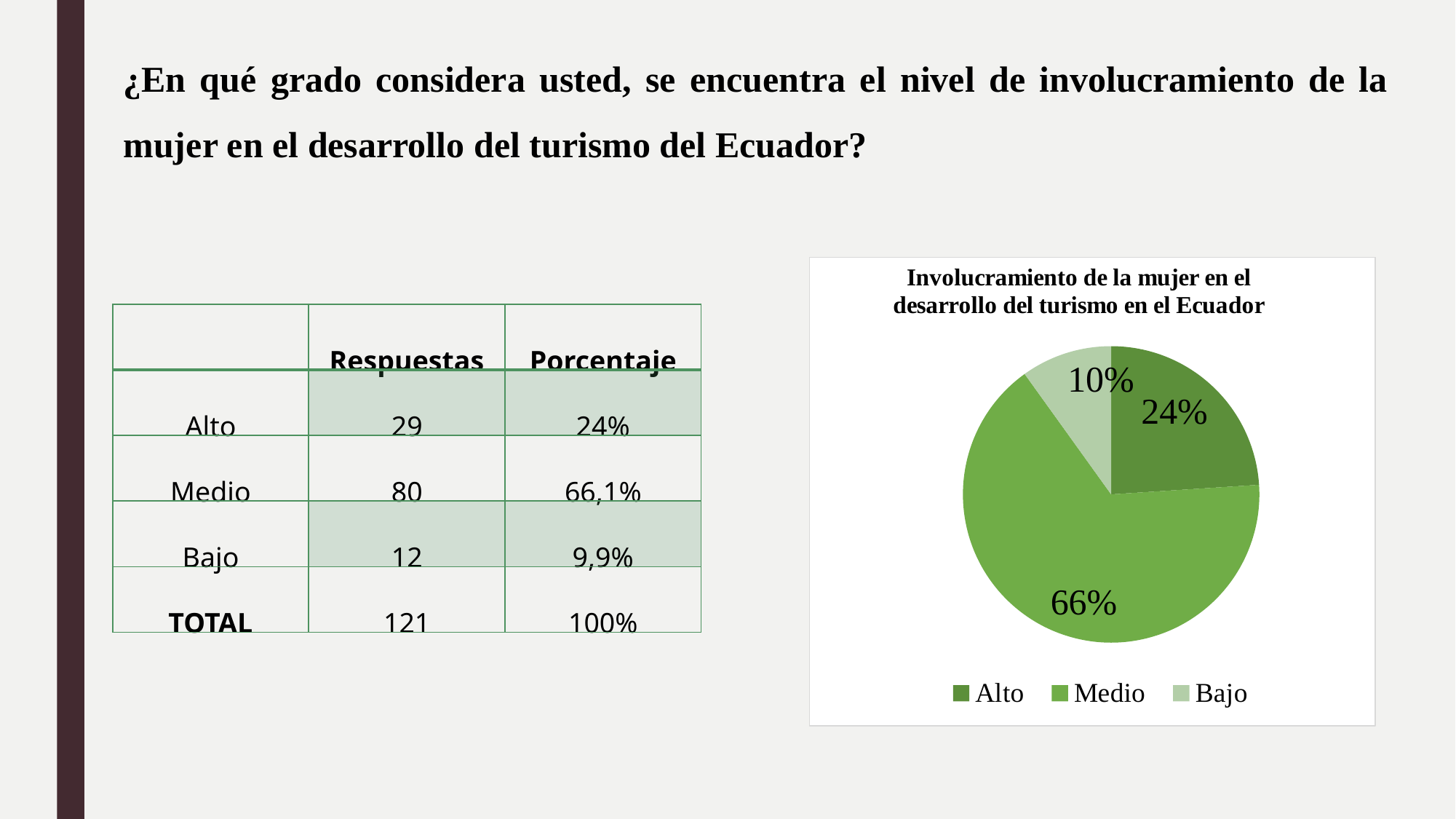
Which category has the largest slice of the pie chart? Medio What percentage does the pie chart show for Bajo? 10% What kind of chart is shown on the slide? pie chart How many slices does the pie chart have? 3 Which category has the smallest slice of the pie chart? Bajo What percentage does the pie chart show for Medio? 66% How many entries does the chart legend list? 3 By how many percentage points does the Medio slice exceed the Alto slice in the pie chart? 42 Which legend entry is shown in the lightest green colour? Bajo What is the title of the chart? Involucramiento de la mujer en el desarrollo del turismo en el Ecuador What percentage does the pie chart show for Alto? 24% Which slice is larger in the pie chart, Alto or Bajo? Alto